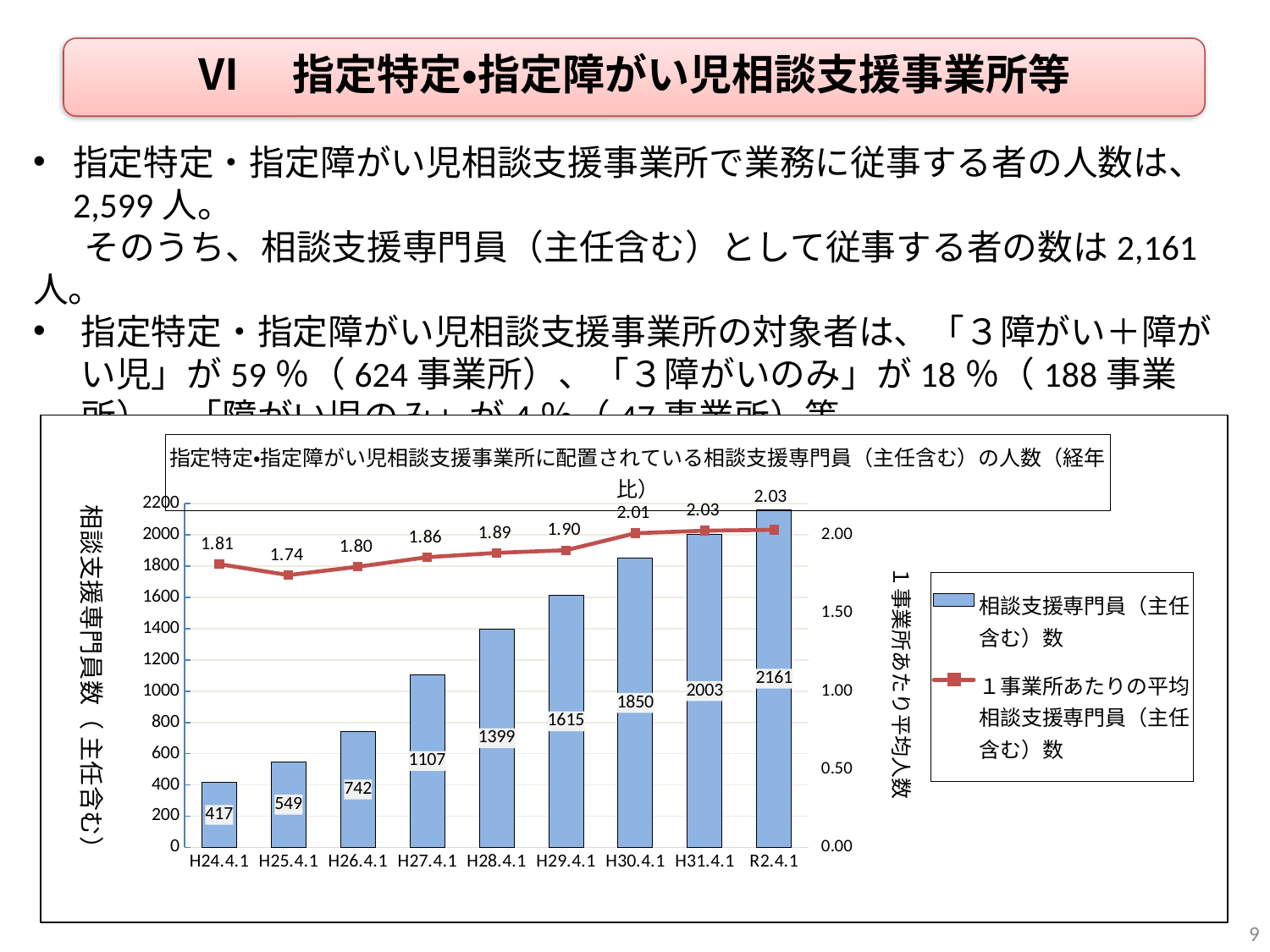
What is the number of 相談支援専門員（主任含む） at R2.4.1? 2161 What is the value of 1事業所あたりの平均相談支援専門員（主任含む）数 at H25.4.1? 1.74 What kind of chart is shown on the slide? Combined bar and line chart What is the number of 相談支援専門員（主任含む） at H28.4.1? 1399 What is the difference in the number of 相談支援専門員（主任含む） between R2.4.1 and H31.4.1? 158 How many series does the chart legend list? 2 At which date is the number of 相談支援専門員（主任含む） lowest? H24.4.1 Which is larger, the number of 相談支援専門員（主任含む） at H27.4.1 or at H26.4.1? H27.4.1 Does the number of 相談支援専門員（主任含む） rise or fall from H24.4.1 to R2.4.1? Rise What colour are the bars in the chart? Blue How many dates are shown on the x axis of the chart? 9 At which date is the 1事業所あたりの平均相談支援専門員（主任含む）数 lowest? H25.4.1